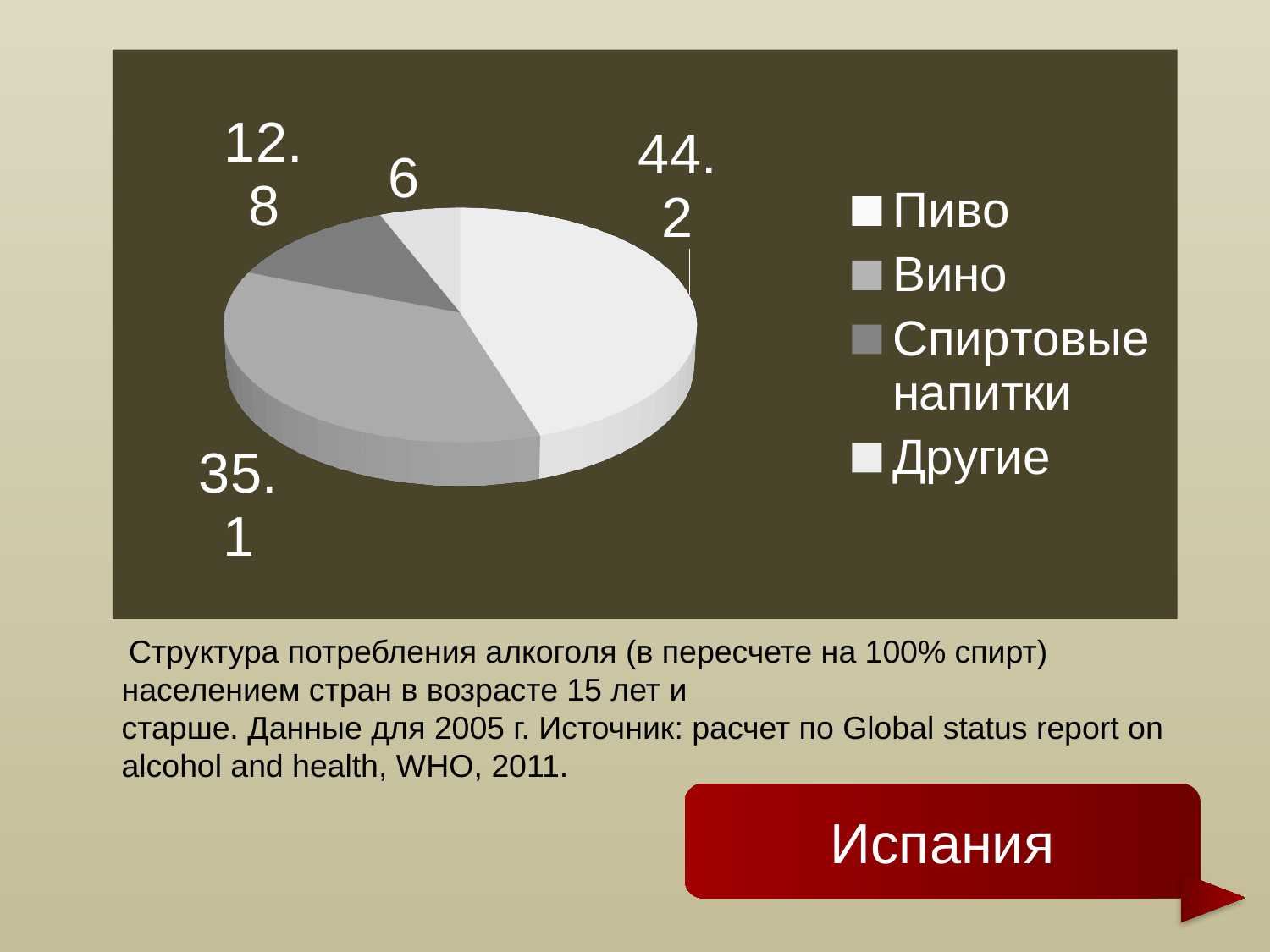
What type of chart is shown on the slide? pie chart Which country is named in the red box below the chart? Испания Which is larger, the value for Вино or the value for Спиртовые напитки? Вино Which category has the smallest slice? Другие Which category has the largest slice? Пиво How many categories does the pie chart have? 4 What is the difference between the values for Пиво and Вино? 9.1 What is the value for Другие? 6 What is the value for Пиво? 44.2 What is the value for Спиртовые напитки? 12.8 What is the difference between the values for Спиртовые напитки and Другие? 6.8 What is the value for Вино? 35.1